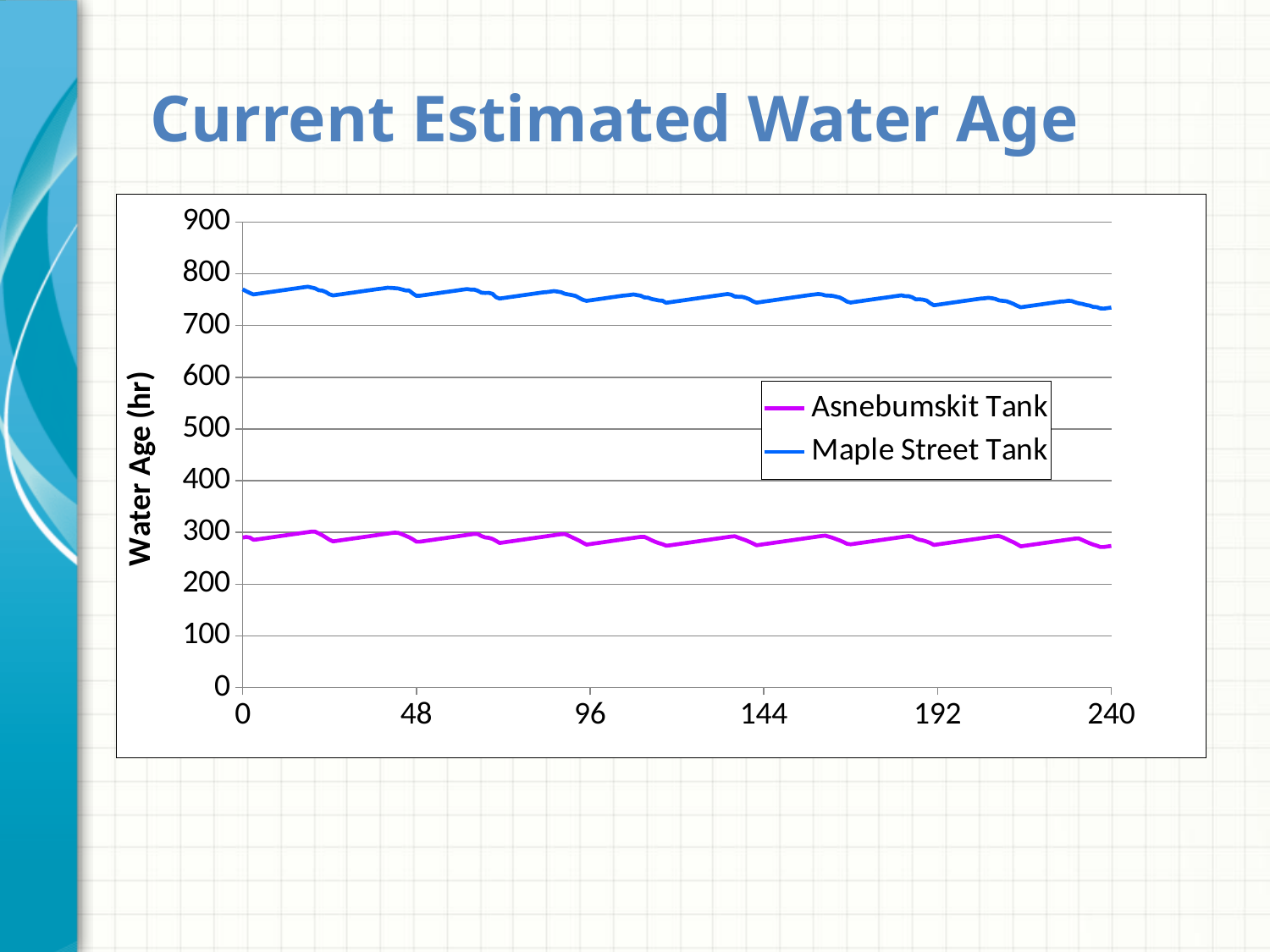
How many series does the legend list? 2 Which series has higher water age values throughout, Asnebumskit Tank or Maple Street Tank? Maple Street Tank What kind of chart is shown on the slide? line chart Which series is drawn in blue? Maple Street Tank What is the largest value shown on the x axis? 240 Is the water age for Maple Street Tank greater or less than 700 hr across the chart? greater What is the title of the slide containing the chart? Current Estimated Water Age Is the water age for Asnebumskit Tank greater or less than 400 hr across the chart? less What is the label of the y axis? Water Age (hr) Is the water age for Asnebumskit Tank greater or less than 200 hr across the chart? greater Does the Maple Street Tank line generally rise or fall from left to right along the x axis? fall